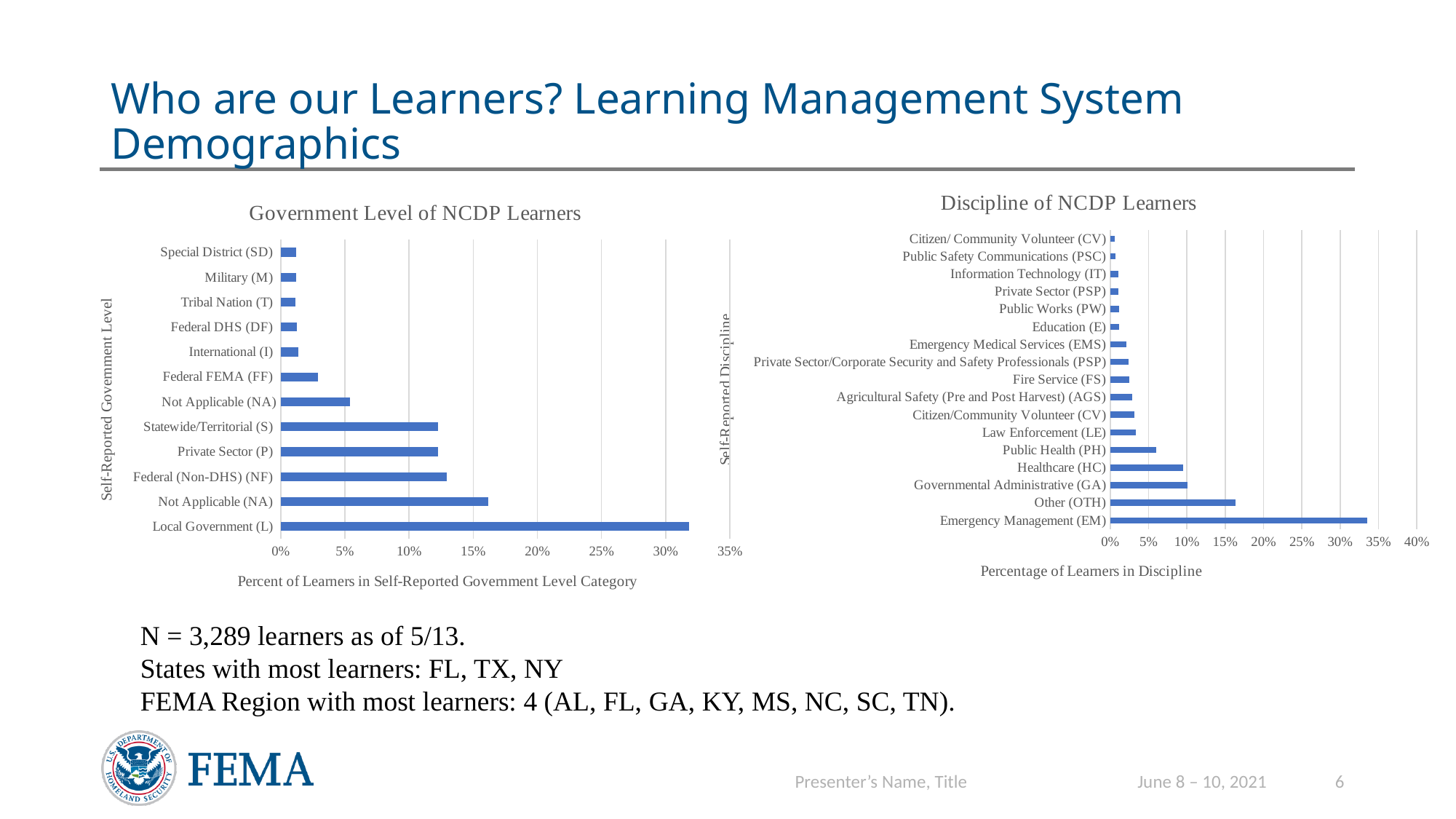
On the Discipline of NCDP Learners chart, which discipline has the highest percentage of learners? Emergency Management (EM) What kind of chart is the Discipline of NCDP Learners chart? Bar chart How many government level categories are shown on the Government Level of NCDP Learners chart? 12 On the Government Level of NCDP Learners chart, is the value for Federal FEMA (FF) greater or less than 5%? less On the Discipline of NCDP Learners chart, is the value for Law Enforcement (LE) greater or less than 5%? less On the Government Level of NCDP Learners chart, is the value for Local Government (L) greater or less than 30%? greater On the Government Level of NCDP Learners chart, which is larger: Local Government (L) or Statewide/Territorial (S)? Local Government (L) On the Government Level of NCDP Learners chart, which government level has the highest percentage of learners? Local Government (L) On the Discipline of NCDP Learners chart, which is larger: Healthcare (HC) or Public Health (PH)? Healthcare (HC)